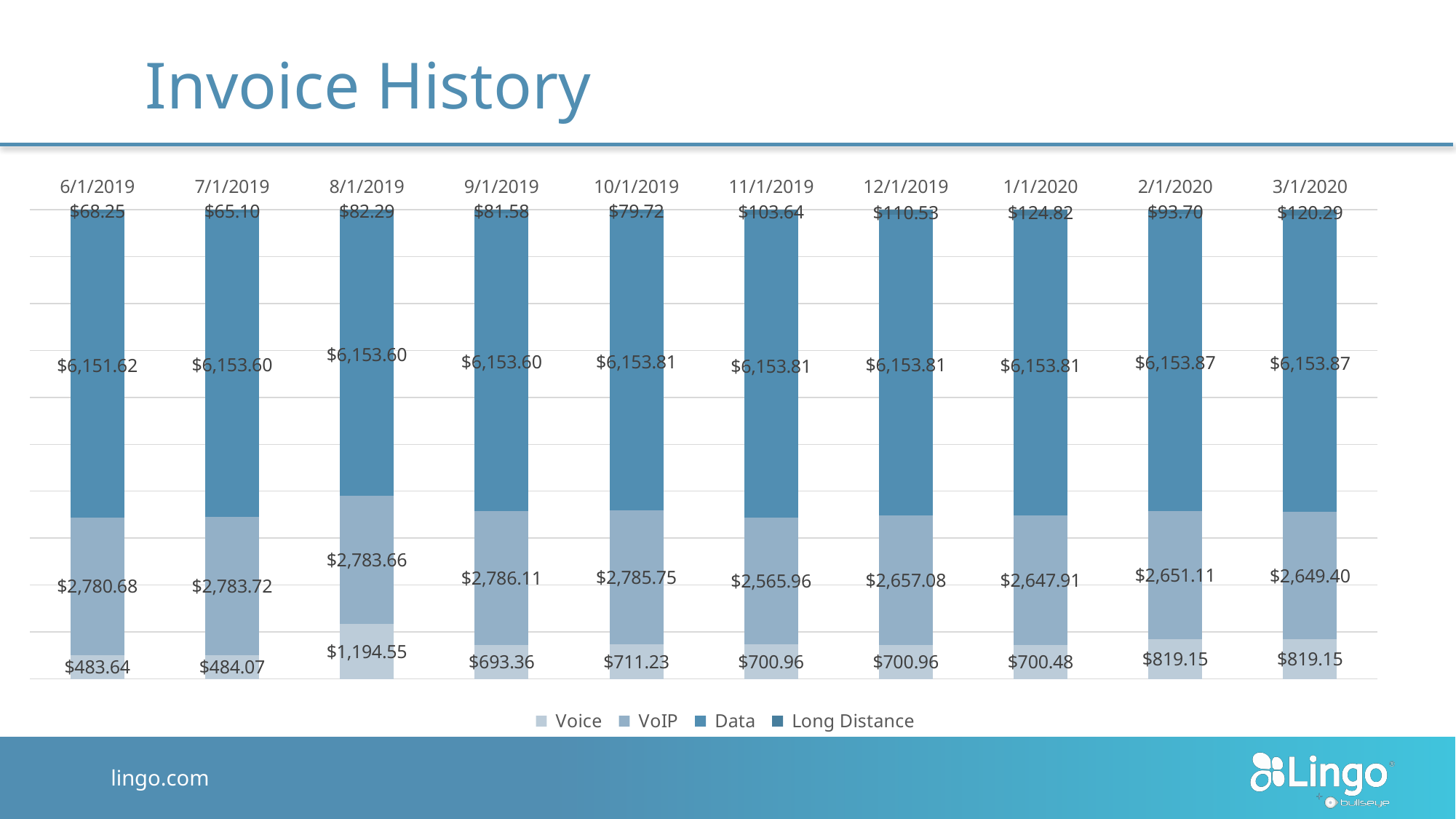
What is the Voice value for 8/1/2019? $1,194.55 What is the difference between the Voice value for 8/1/2019 and the Voice value for 7/1/2019? $710.48 Which month has the lowest Long Distance value? 7/1/2019 What is the total of the stacked bar for 8/1/2019? $10,214.10 What is the VoIP value for 11/1/2019? $2,565.96 What kind of chart is shown on the slide? Stacked bar chart Which is larger, the Long Distance value for 1/1/2020 or for 2/1/2020? 1/1/2020 What is the Long Distance value for 1/1/2020? $124.82 How many series does the legend list? 4 How many months are shown on the chart? 10 Which month has the highest Voice value? 8/1/2019 What is the Data value for 6/1/2019? $6,151.62